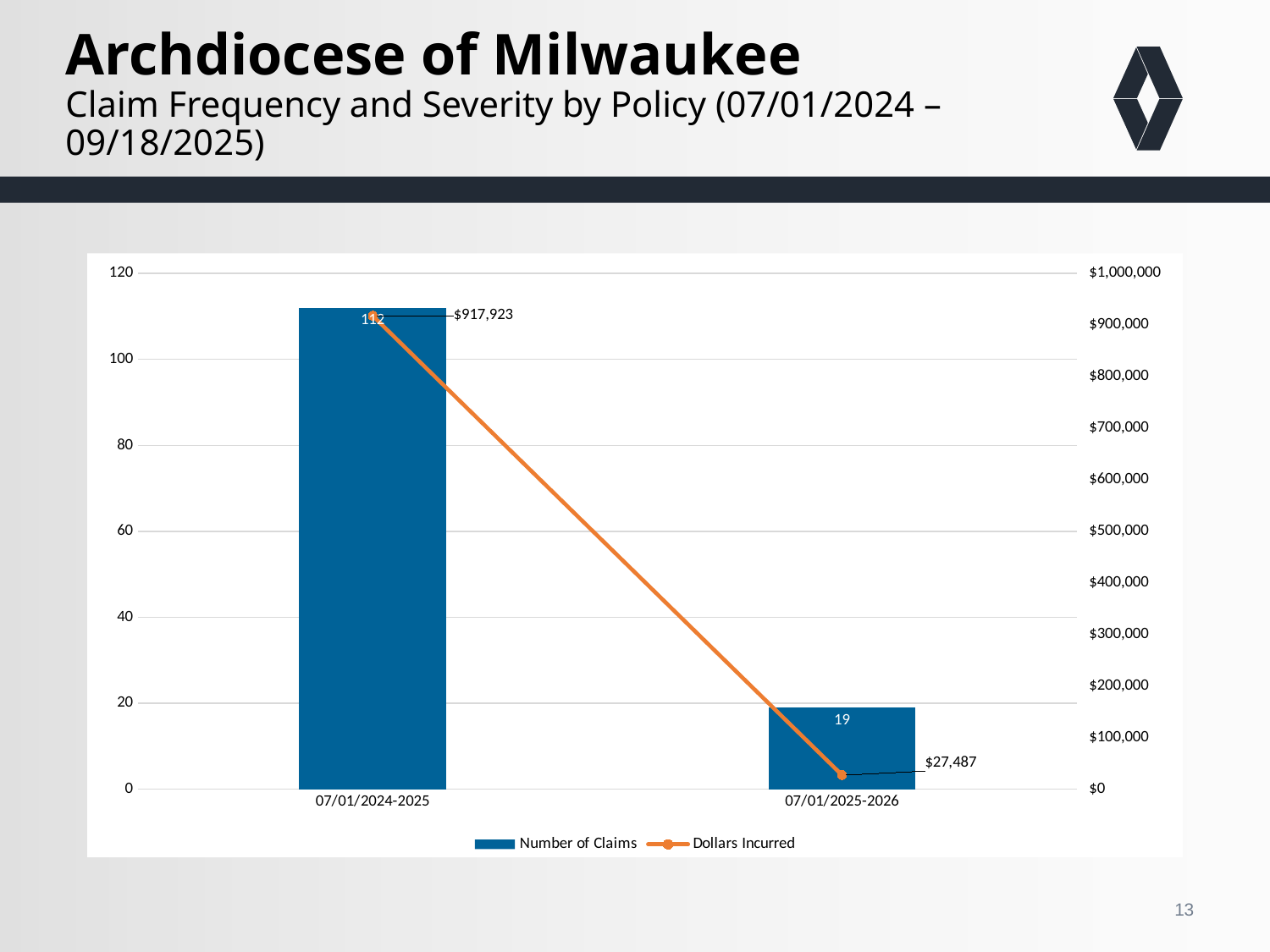
What is the Number of Claims for 07/01/2024-2025? 112 Which policy period has the lowest Dollars Incurred? 07/01/2025-2026 How many series does the legend list? 2 What is the difference in Number of Claims between 07/01/2024-2025 and 07/01/2025-2026? 93 What are the Dollars Incurred for 07/01/2024-2025? $917,923 What are the Dollars Incurred for 07/01/2025-2026? $27,487 How many policy periods are shown on the x axis? 2 Do the Dollars Incurred rise or fall from 07/01/2024-2025 to 07/01/2025-2026? fall Which policy period has more Dollars Incurred, 07/01/2024-2025 or 07/01/2025-2026? 07/01/2024-2025 What is the difference in Dollars Incurred between 07/01/2024-2025 and 07/01/2025-2026? $890,436 Which policy period has the highest Number of Claims? 07/01/2024-2025 What is the Number of Claims for 07/01/2025-2026? 19